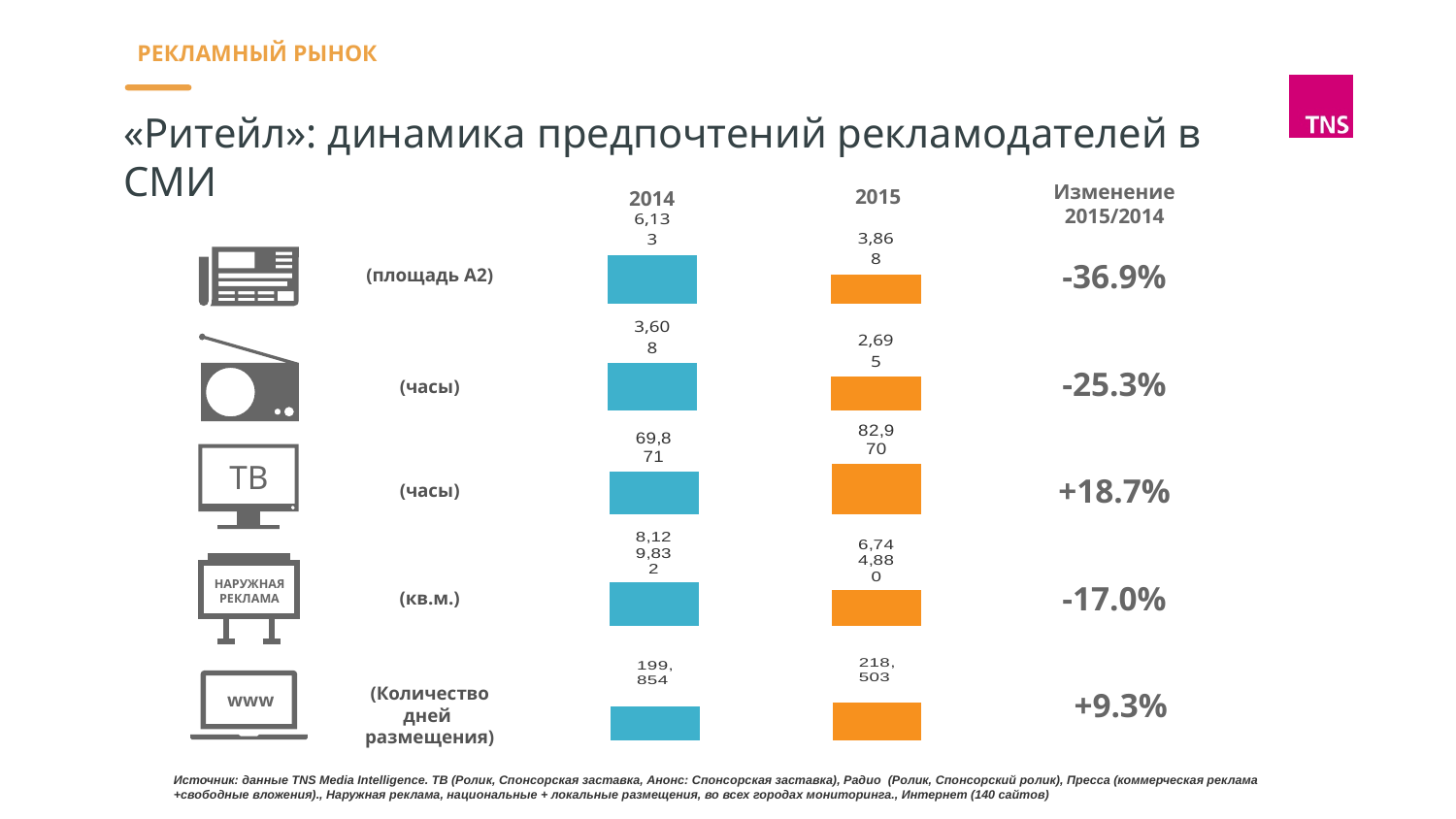
What is the change 2015/2014 shown for the outdoor advertising row (кв.м.)? -17.0% How many years (series) are compared in the chart? 2 What is the change 2015/2014 shown for the radio row (second row, часы)? -25.3% What is the difference between the 2015 and 2014 values for the internet row (Количество дней размещения)? 18,649 How many media rows are shown on the slide? 5 For the TV row, which year has the larger value, 2014 or 2015? 2015 Which row shows the largest increase in the Изменение 2015/2014 column? TV (часы), +18.7% What is the 2015 value for the TV row (часы)? 82,970 Which row shows the largest decline in the Изменение 2015/2014 column? Press (площадь А2), -36.9% What is the 2014 value for the press row labelled (площадь А2)? 6,133 What is the 2015 value for the press row labelled (площадь А2)? 3,868 What is the 2014 value for the internet row (Количество дней размещения)? 199,854